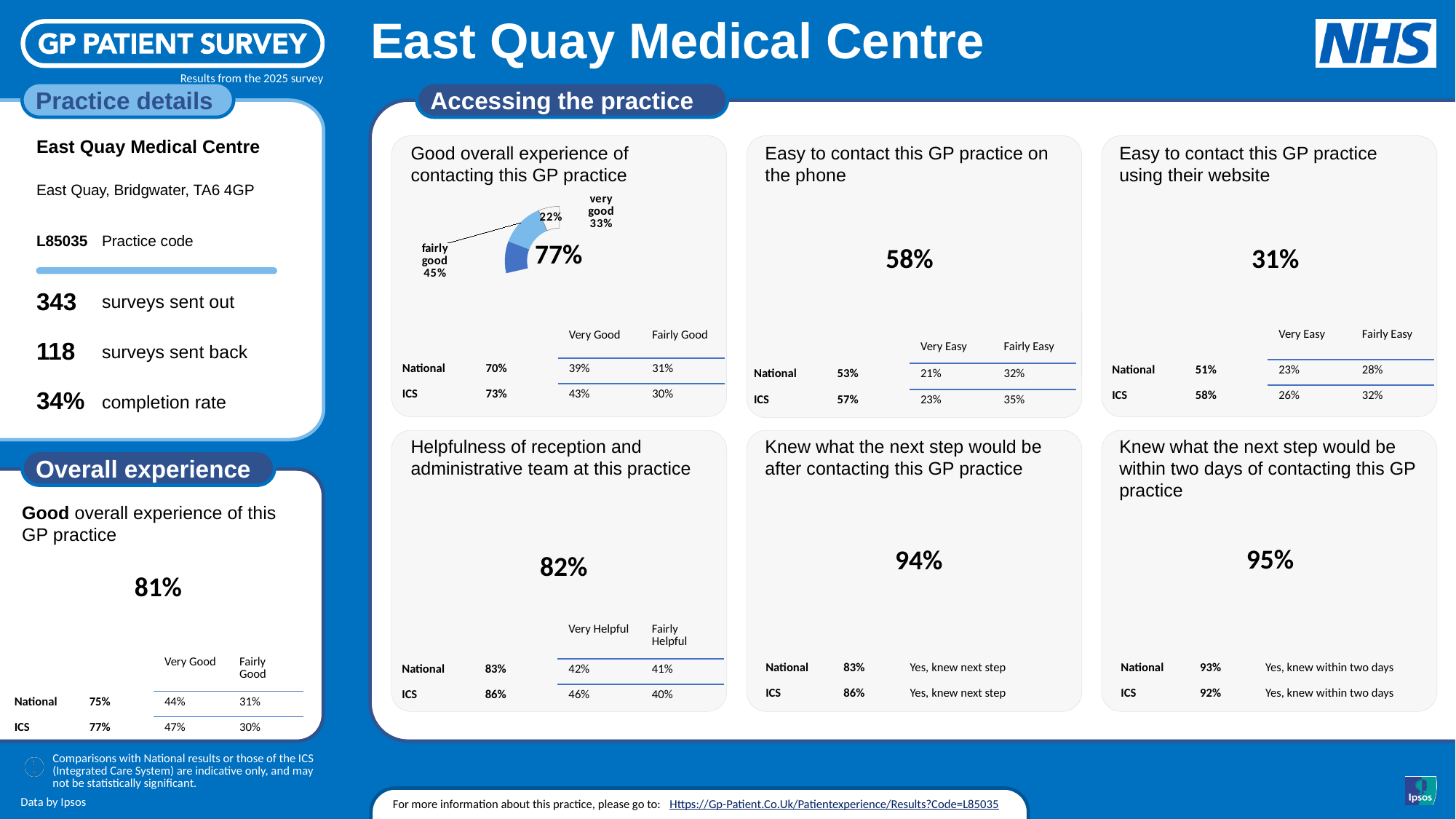
What is the title of the panel containing the pie chart on the slide? Good overall experience of contacting this GP practice In the 'Good overall experience of contacting this GP practice' chart, what percentage is labelled 'very good'? 33% In the 'Good overall experience of contacting this GP practice' chart, what is the third percentage label shown besides 'very good' and 'fairly good'? 22% What is the large percentage printed in the centre of the 'Good overall experience of contacting this GP practice' chart? 77% In the 'Good overall experience of contacting this GP practice' chart, is the 'very good' share greater or less than 40%? less In the 'Good overall experience of contacting this GP practice' chart, which labelled category has the smallest percentage? very good In the 'Good overall experience of contacting this GP practice' chart, which is larger: 'very good' or 'fairly good'? fairly good What kind of chart is shown in the 'Good overall experience of contacting this GP practice' panel? pie chart In the 'Good overall experience of contacting this GP practice' chart, what is the difference in percentage points between 'fairly good' and 'very good'? 12 In the 'Good overall experience of contacting this GP practice' chart, what percentage is labelled 'fairly good'? 45%